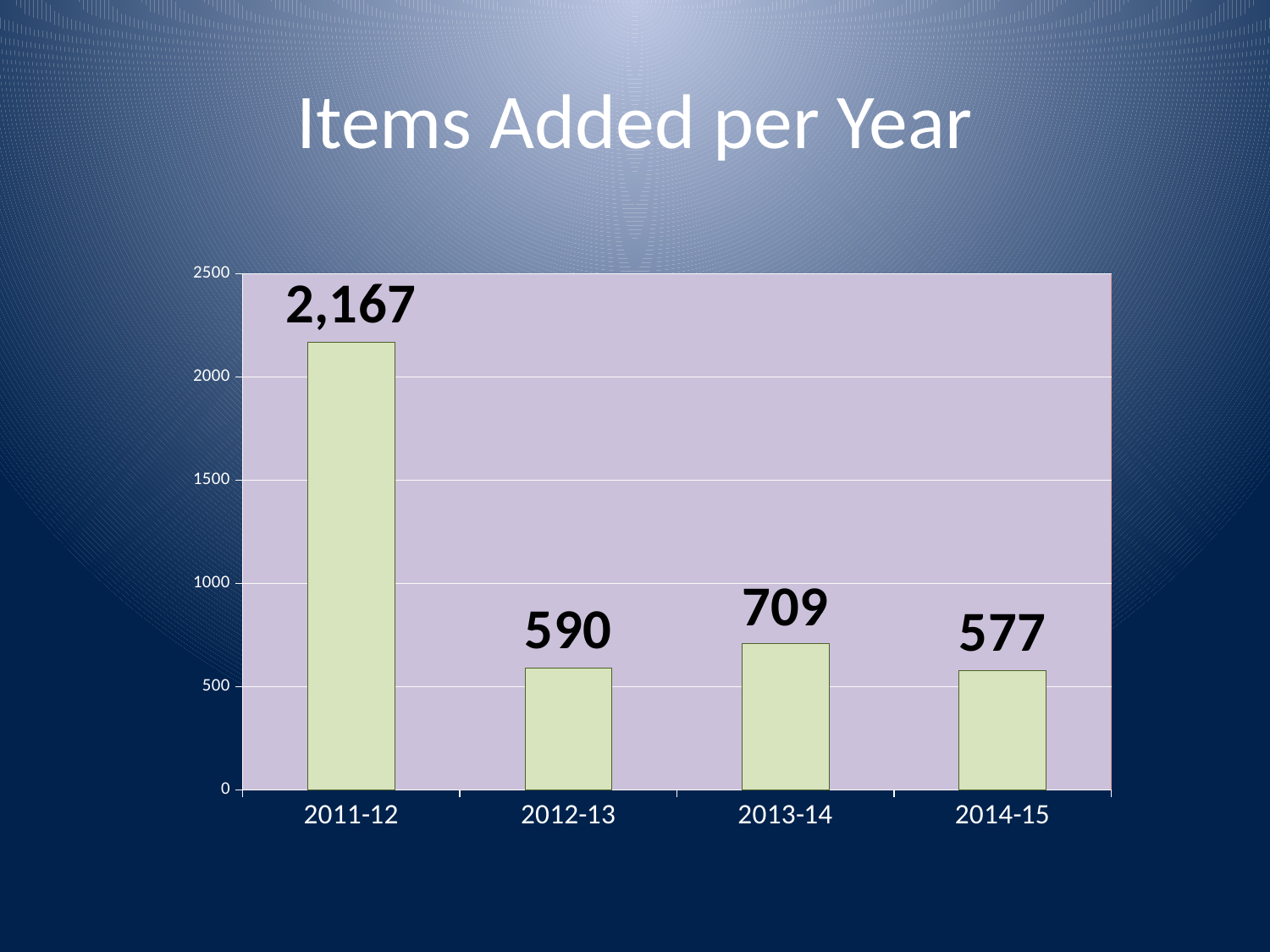
What is the difference between the values for 2013-14 and 2014-15? 132 What is the value for 2012-13? 590 Which is larger, the value for 2012-13 or the value for 2013-14? 2013-14 What is the value for 2011-12? 2,167 Which year has the highest number of items added? 2011-12 What is the value for 2014-15? 577 Is the value for 2011-12 greater or less than 2000? greater What kind of chart is shown on the slide? bar chart How many years are shown on the chart? 4 What is the value for 2013-14? 709 What is the difference between the values for 2011-12 and 2012-13? 1,577 Which year has the lowest number of items added? 2014-15